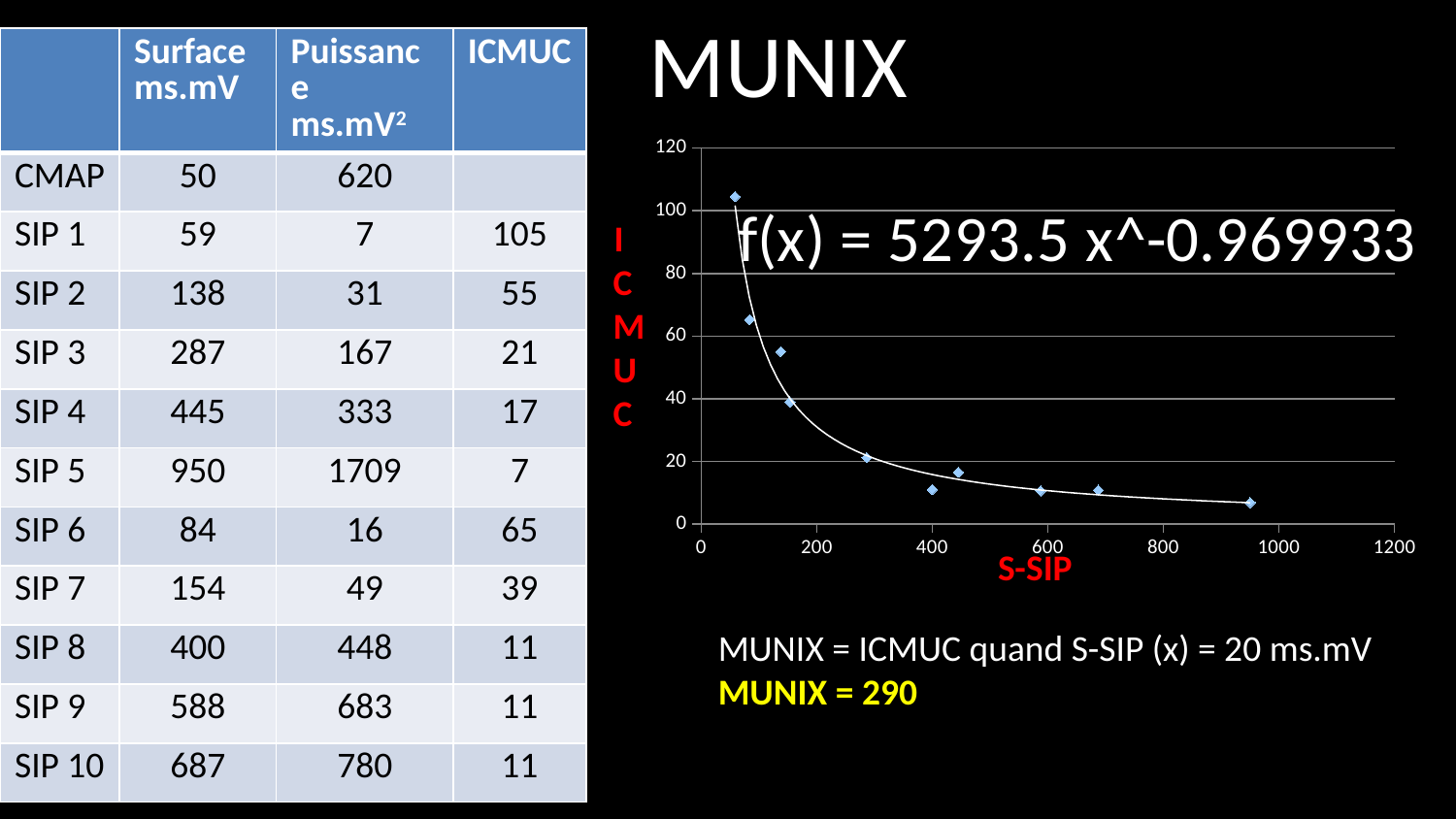
What kind of chart is shown on the slide? scatter chart What is the highest tick value shown on the x axis? 1200 How many data points are plotted on the chart? 10 Is the ICMUC value of the leftmost point greater or less than 80? greater Is the ICMUC value of the rightmost point (near S-SIP 950) greater or less than 20? less Is the ICMUC value of the point near S-SIP 400 greater or less than 20? less What is the highest tick value shown on the y axis? 120 What is the trendline equation displayed on the chart? f(x) = 5293.5 x^-0.969933 What is the label of the x axis of the chart? S-SIP Which point has the highest ICMUC value: the one with the smallest S-SIP or the one with the largest S-SIP? the one with the smallest S-SIP As S-SIP increases along the x axis, do the ICMUC values rise or fall? fall